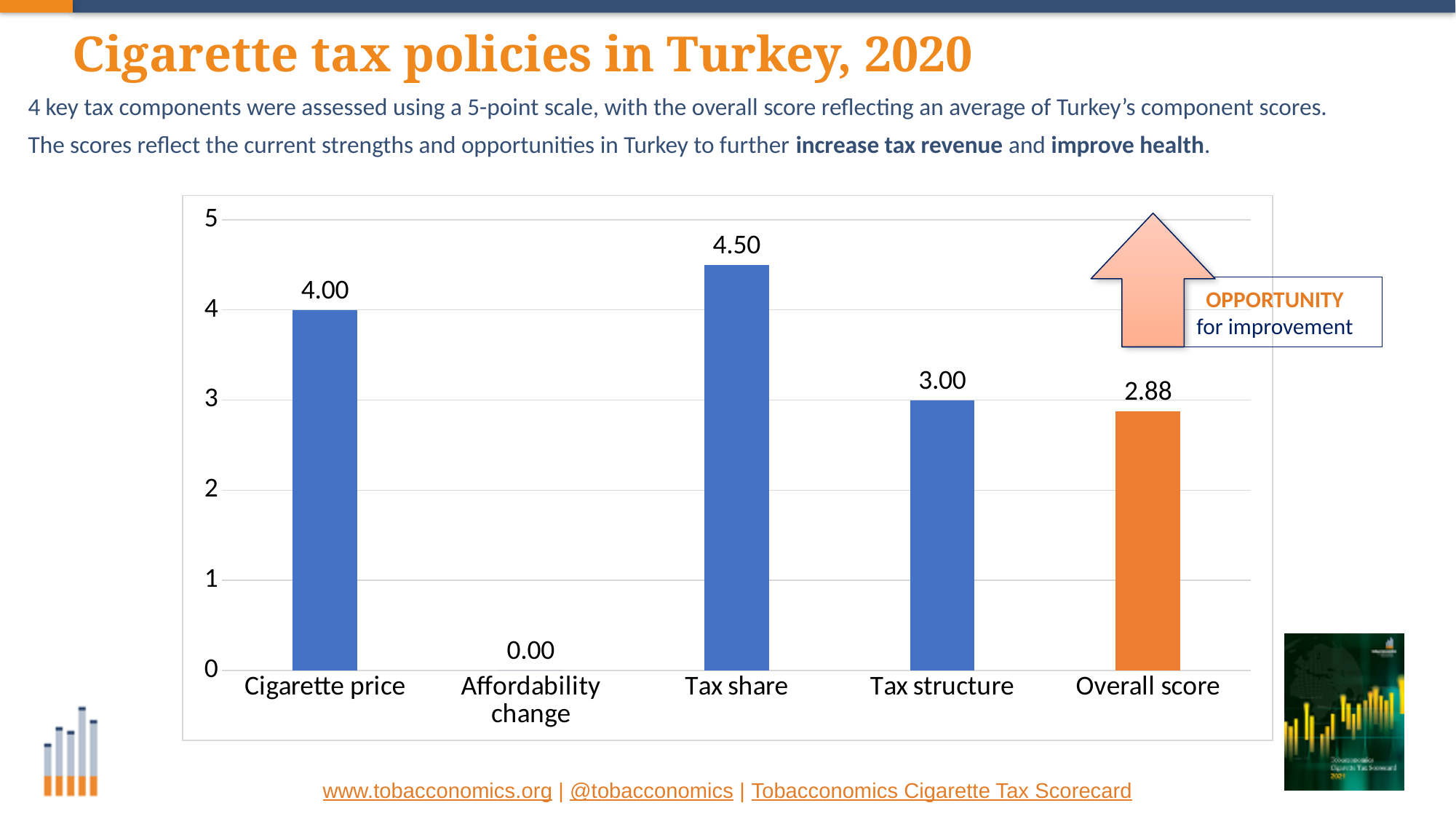
What kind of chart is shown on the slide? bar chart Which category has the lowest value? Affordability change What is the value for Cigarette price? 4.00 What is the difference between the values for Tax share and Tax structure? 1.50 Which bar is coloured orange rather than blue? Overall score How many categories are shown on the x axis? 5 What is the Overall score shown on the chart? 2.88 Which category has the highest value? Tax share What is the value for Tax share? 4.50 What is the value for Affordability change? 0.00 Is the value for Overall score greater or less than 3? less Which is larger, the value for Cigarette price or the value for Tax structure? Cigarette price